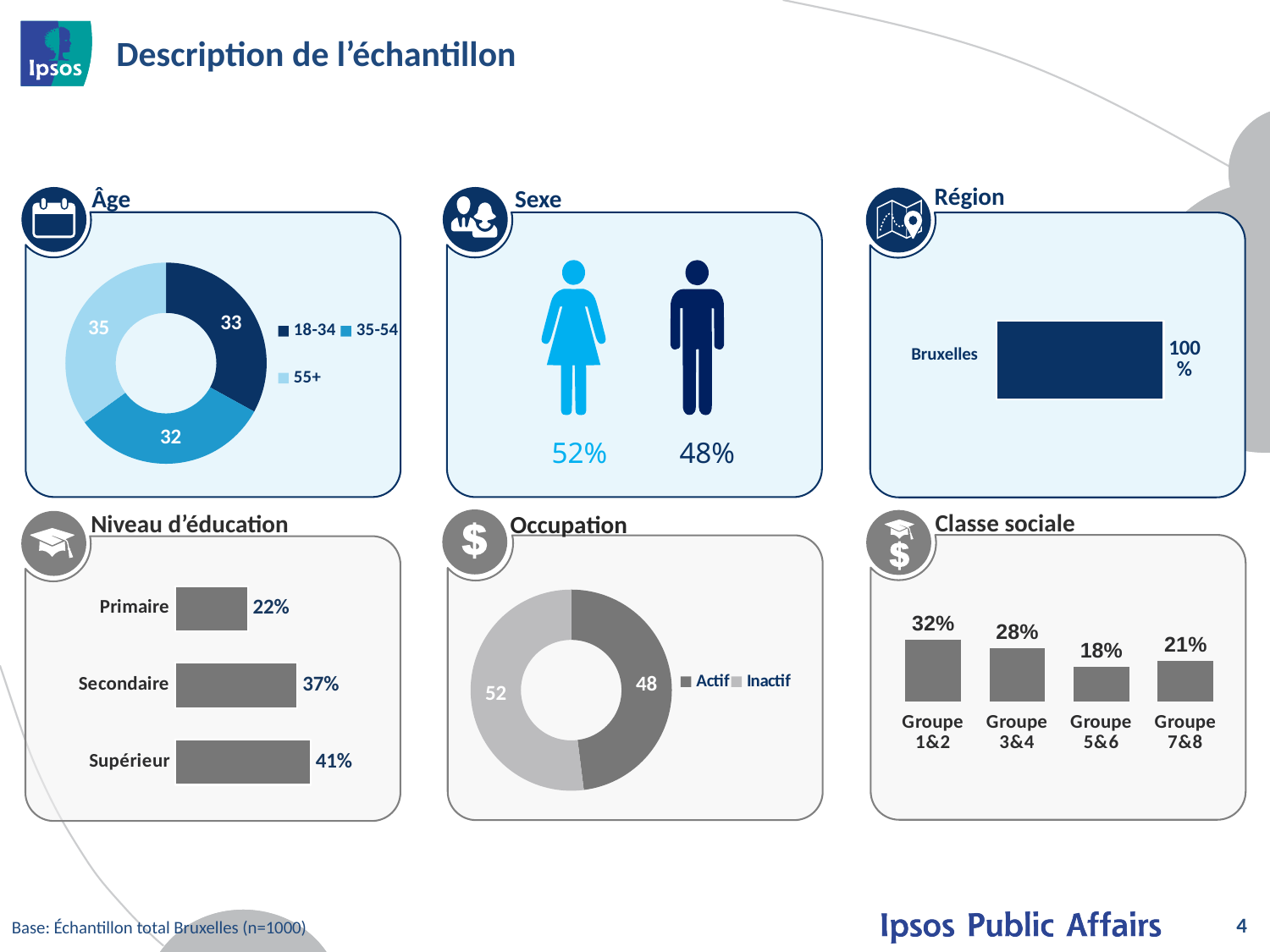
In the Âge chart, how many categories does the legend list? 3 In the Occupation chart, what is the value for Inactif? 52 In the Classe sociale chart, how many groups are shown? 4 In the Niveau d'éducation chart, what is the difference between Supérieur and Primaire? 19% In the Âge chart, which age group has the lowest value? 35-54 What kind of chart is the Niveau d'éducation chart? Bar chart In the Classe sociale chart, what is the value for Groupe 5&6? 18% In the Niveau d'éducation chart, what is the value for Secondaire? 37% In the Niveau d'éducation chart, which category has the highest value? Supérieur In the Âge chart, what is the value for the 55+ category? 35 In the Région chart, what is the value for Bruxelles? 100% In the Occupation chart, which is larger, Actif or Inactif? Inactif